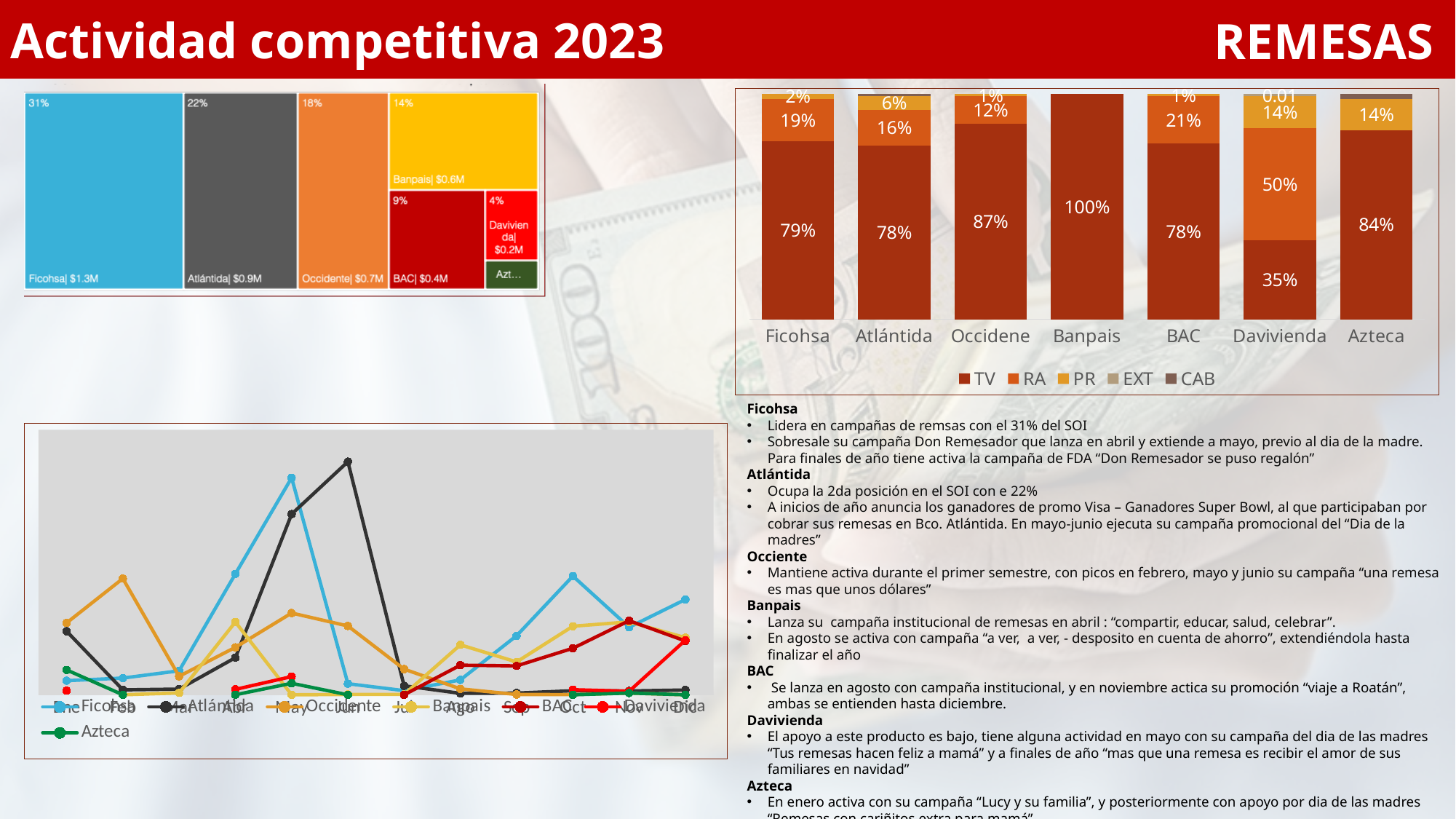
In the line chart at the bottom left, in which month does the Atlántida line reach its highest point? Jun In the stacked bar chart on the top right, which bank has the lowest TV share? Davivienda In the treemap on the top left, what share does Ficohsa hold? 31% In the stacked bar chart on the top right, what is the RA share for Davivienda? 50% How many banks are shown on the x axis of the stacked bar chart on the top right? 7 What kind of chart is shown at the bottom left of the slide? Line chart In the stacked bar chart on the top right, which bank has a TV share of 100%? Banpais In the stacked bar chart on the top right, what is the TV share for Occidene? 87% In the stacked bar chart on the top right, what is the difference between the TV share of Azteca and the TV share of Davivienda? 49% In the treemap on the top left, what dollar amount is shown for Banpais? $0.6M In the stacked bar chart on the top right, is the RA share larger for BAC or for Ficohsa? BAC How many series does the legend of the stacked bar chart on the top right list? 5